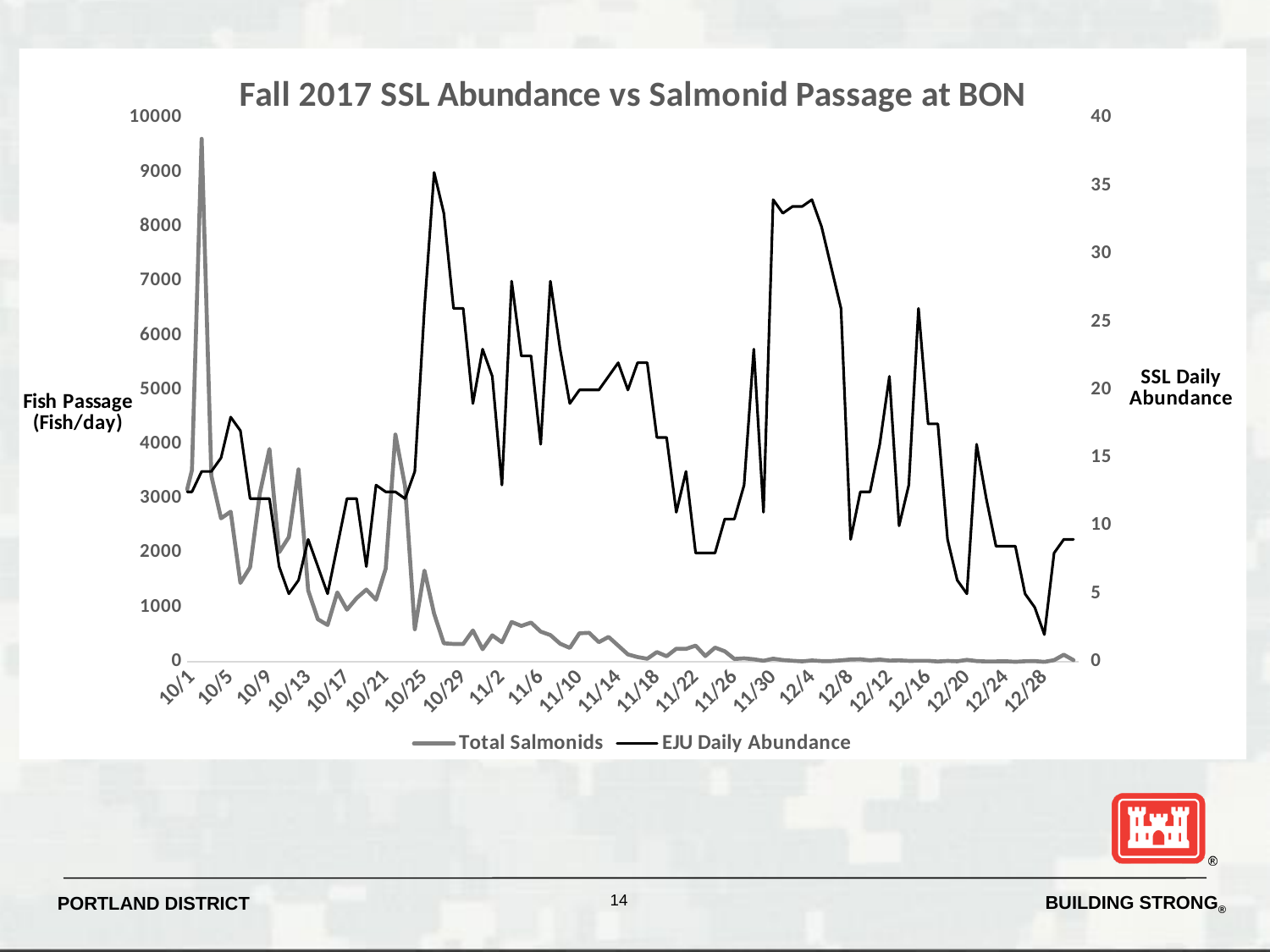
Is the value for Total Salmonids on 12/28 greater or less than 1000? less What is the highest value shown on the left vertical axis (Fish Passage)? 10000 Overall, does the Total Salmonids series rise or fall from 10/1 to 12/28? fall Is the peak value of Total Salmonids in early October greater or less than 9000? greater What is the highest value shown on the right vertical axis (SSL Daily Abundance)? 40 Is the value for EJU Daily Abundance on 12/28 greater or less than 5? less How many series does the legend list? 2 How many date labels are shown along the x axis? 23 What kind of chart is shown on the slide? Line chart What is the title of the chart? Fall 2017 SSL Abundance vs Salmonid Passage at BON Which series is plotted in black? EJU Daily Abundance